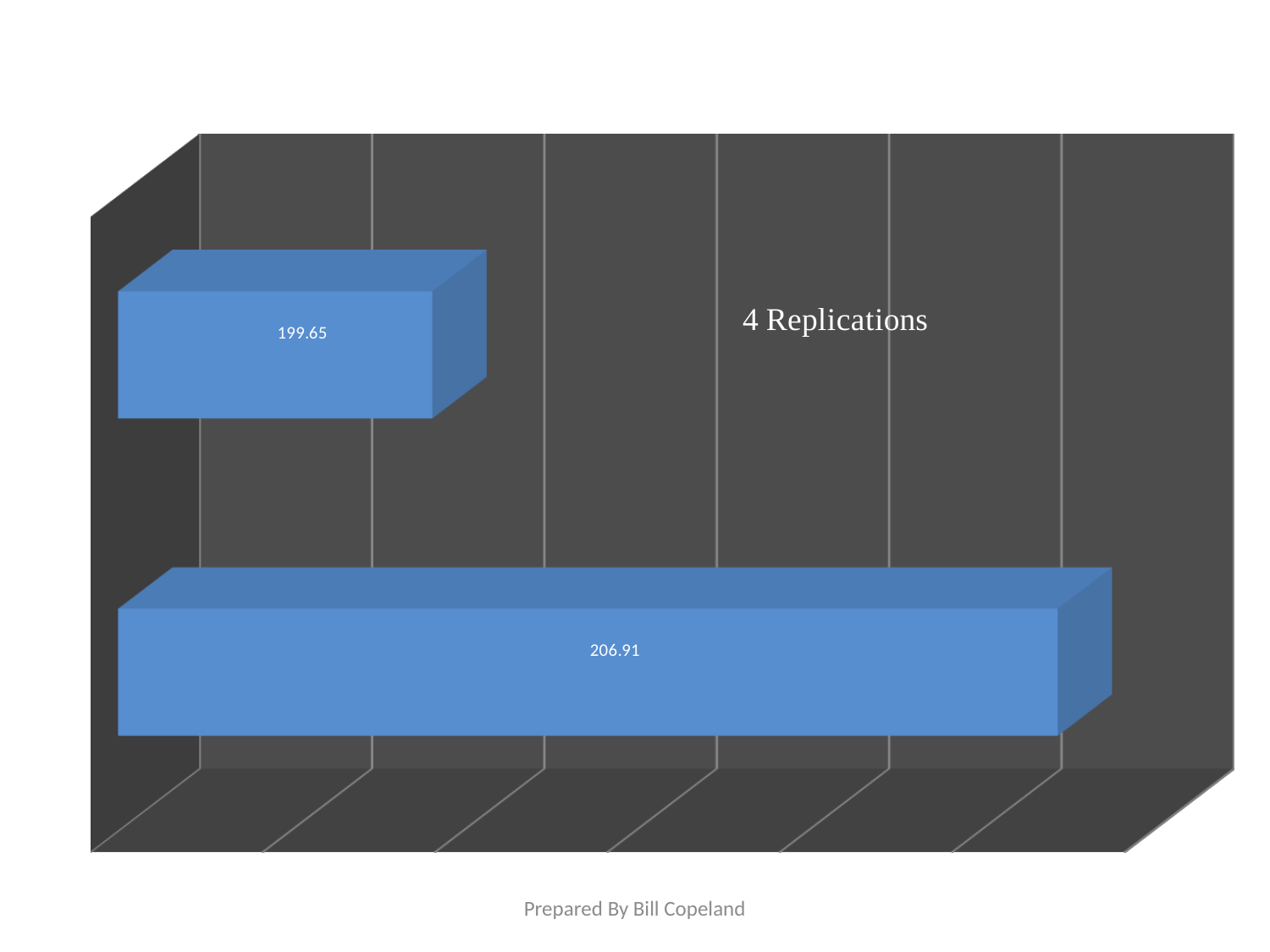
What colour are the bars in the chart? blue What kind of chart is shown on the slide? bar chart Which bar has the higher value, the top bar or the bottom bar? the bottom bar What is the difference between the bottom bar's value and the top bar's value? 7.26 How many bars are plotted in the chart? 2 What text label appears inside the chart area to the right of the top bar? 4 Replications Is the value of the bottom bar larger or smaller than the value of the top bar? larger Which bar has the lower value, the top bar or the bottom bar? the top bar What is the value shown on the bottom bar? 206.91 What is the value shown on the top bar? 199.65